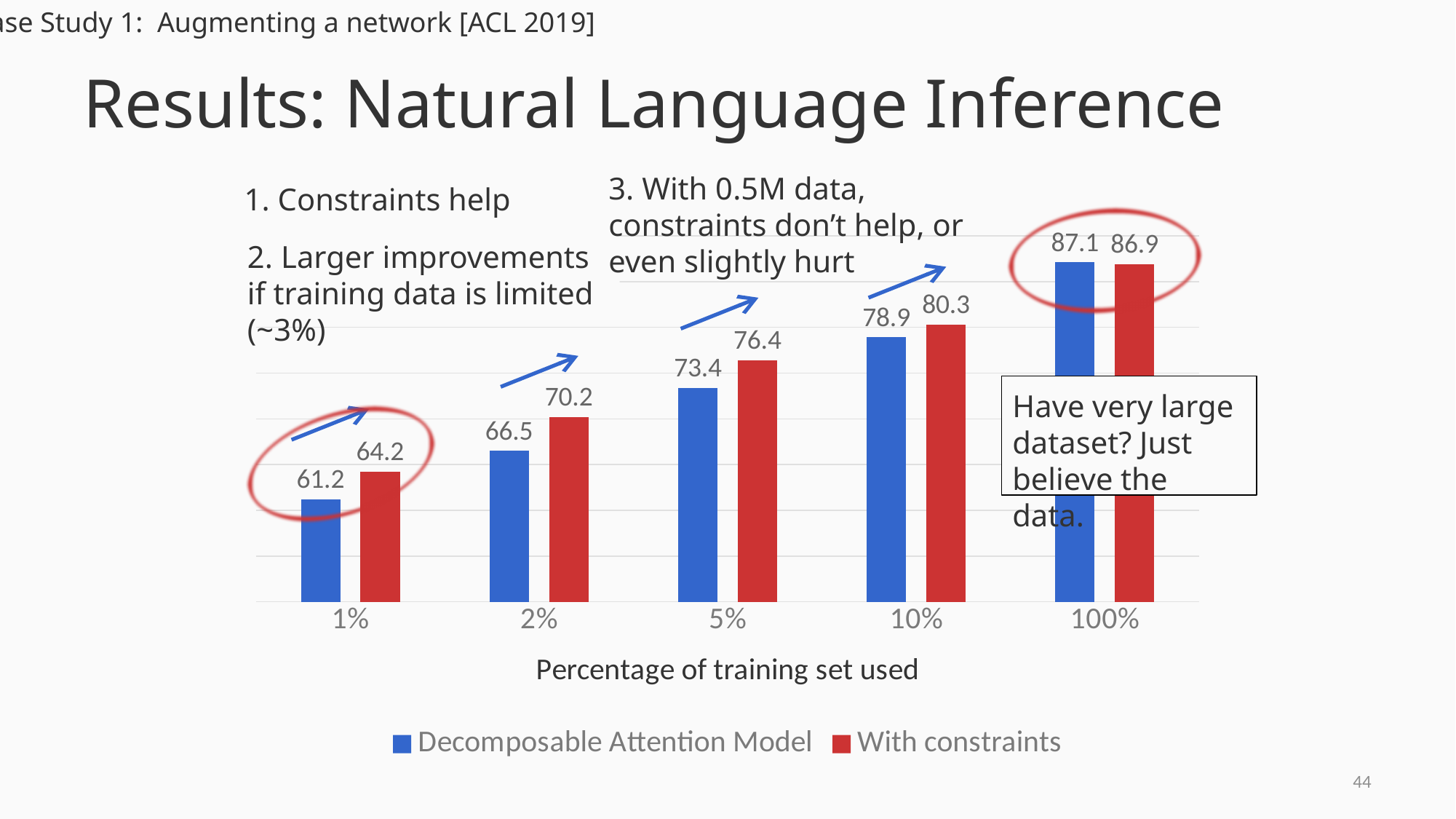
What is the value for the Decomposable Attention Model at 1% of the training set? 61.2 At 100% of the training set, which series has the larger value: Decomposable Attention Model or With constraints? Decomposable Attention Model How many percentage-of-training-set categories are shown on the x axis? 5 At which percentage of the training set is the With constraints value lowest? 1% What is the value for With constraints at 100% of the training set? 86.9 What is the difference between the With constraints value and the Decomposable Attention Model value at 2% of the training set? 3.7 Do the With constraints values rise or fall as the percentage of training set used increases from 1% to 100%? rise What is the value for the Decomposable Attention Model at 10% of the training set? 78.9 At which percentage of the training set is the Decomposable Attention Model value highest? 100% What is the value for With constraints at 5% of the training set? 76.4 What kind of chart is shown on the slide? bar chart How many series does the legend list? 2